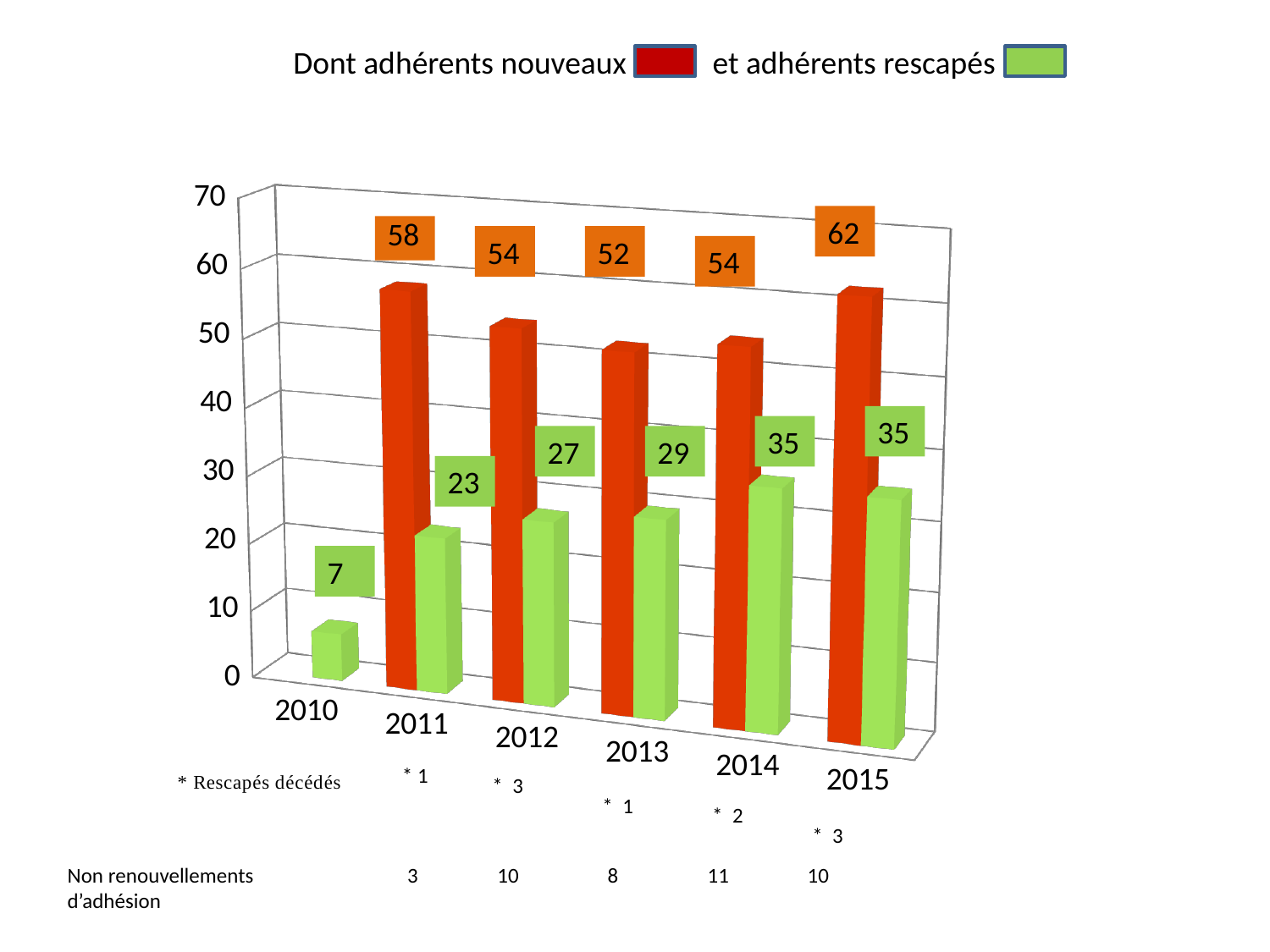
What is the value for adhérents rescapés in 2013? 29 Which year has the lowest value for adhérents rescapés? 2010 What colour represents adhérents rescapés in the legend? green Which is larger: adhérents nouveaux in 2013 or adhérents nouveaux in 2014? 2014 How many series does the legend list? 2 What kind of chart is shown on the slide? bar chart What is the value for adhérents rescapés in 2010? 7 Do the values for adhérents rescapés rise or fall from 2010 to 2014? rise Which year has the highest value for adhérents nouveaux? 2015 What is the value for adhérents nouveaux in 2015? 62 How many years are shown on the x axis? 6 What is the difference between adhérents nouveaux and adhérents rescapés in 2011? 35